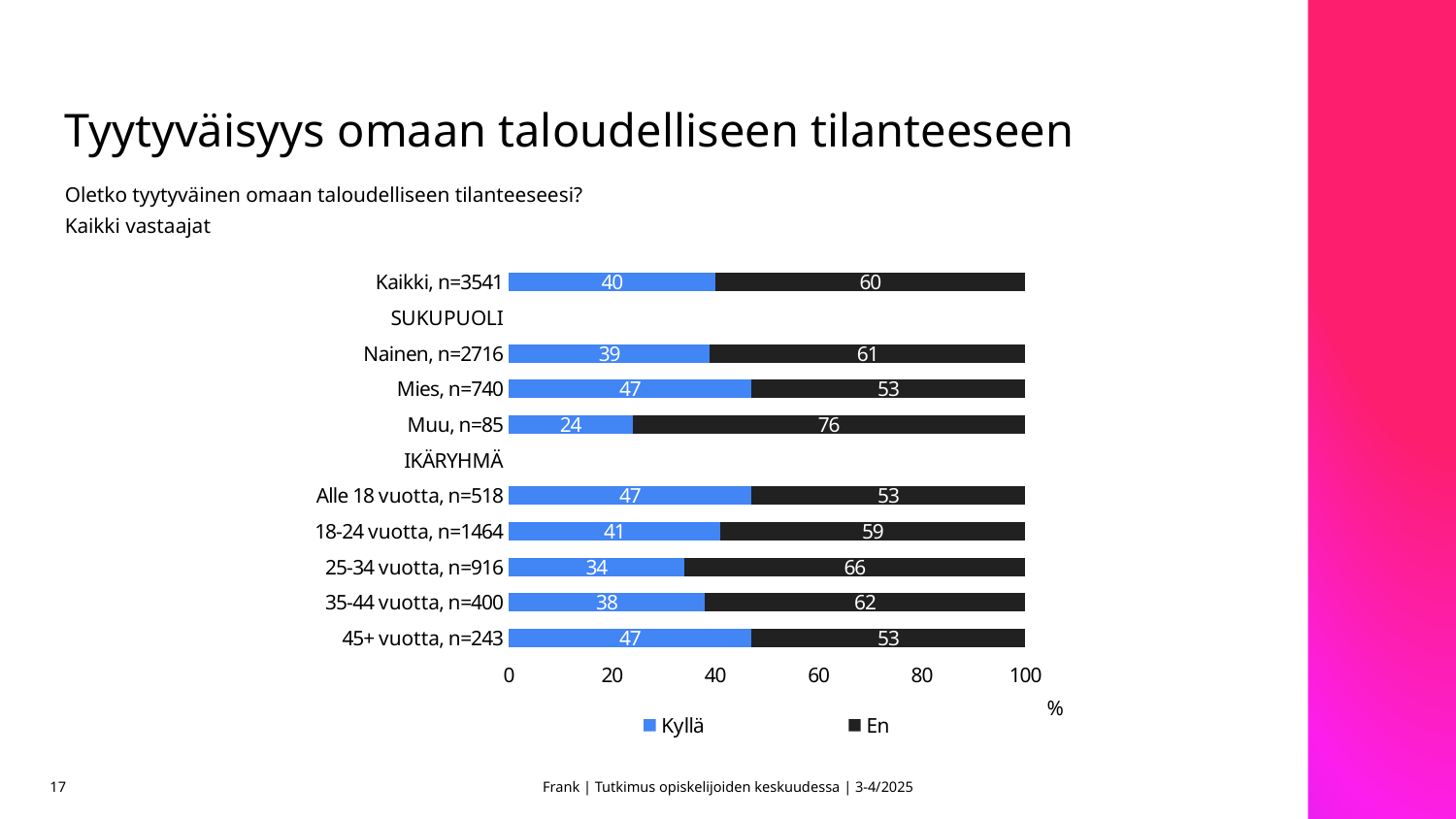
Which has a larger Kyllä value, 18-24 vuotta, n=1464 or 35-44 vuotta, n=400? 18-24 vuotta, n=1464 What kind of chart is shown on the slide? Stacked bar chart Which age group has the lowest Kyllä value? 25-34 vuotta, n=916 What are the two legend entries of the chart? Kyllä and En What is the Kyllä value for Kaikki, n=3541? 40 Which category has the lowest Kyllä value? Muu, n=85 How many series does the legend list? 2 What is the Kyllä value for 25-34 vuotta, n=916? 34 What is the En value for Muu, n=85? 76 What is the total of the stacked bar for 45+ vuotta, n=243? 100 What is the difference between the Kyllä values for Mies, n=740 and Nainen, n=2716? 8 How many categories have bars plotted in the chart? 9